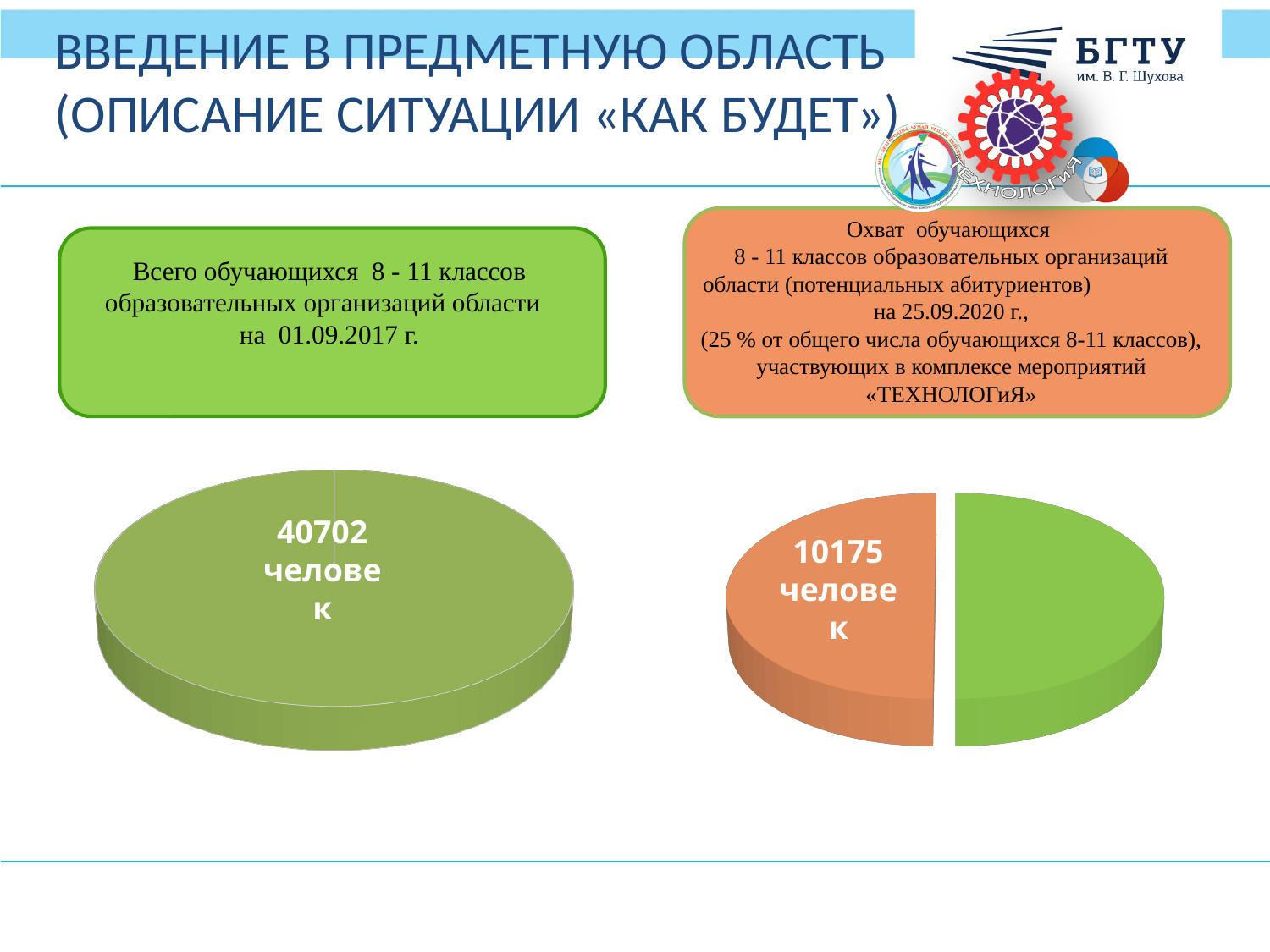
Which is larger: the value printed on the left chart (40702) or the value printed on the right chart (10175)? 40702 What kind of chart is the chart on the left of the slide? pie chart How many slices does the left pie chart have? 1 On the right chart, what value is printed on the orange slice? 10175 человек On the left chart, what value is printed on the pie? 40702 человек How many slices does the right pie chart have? 2 On the right chart, what colour is the slice that carries the data label? orange On the left chart, what colour is the pie? green What kind of chart is the chart on the right of the slide? pie chart What is the difference between the value printed on the left chart (40702) and the value printed on the right chart (10175)? 30527